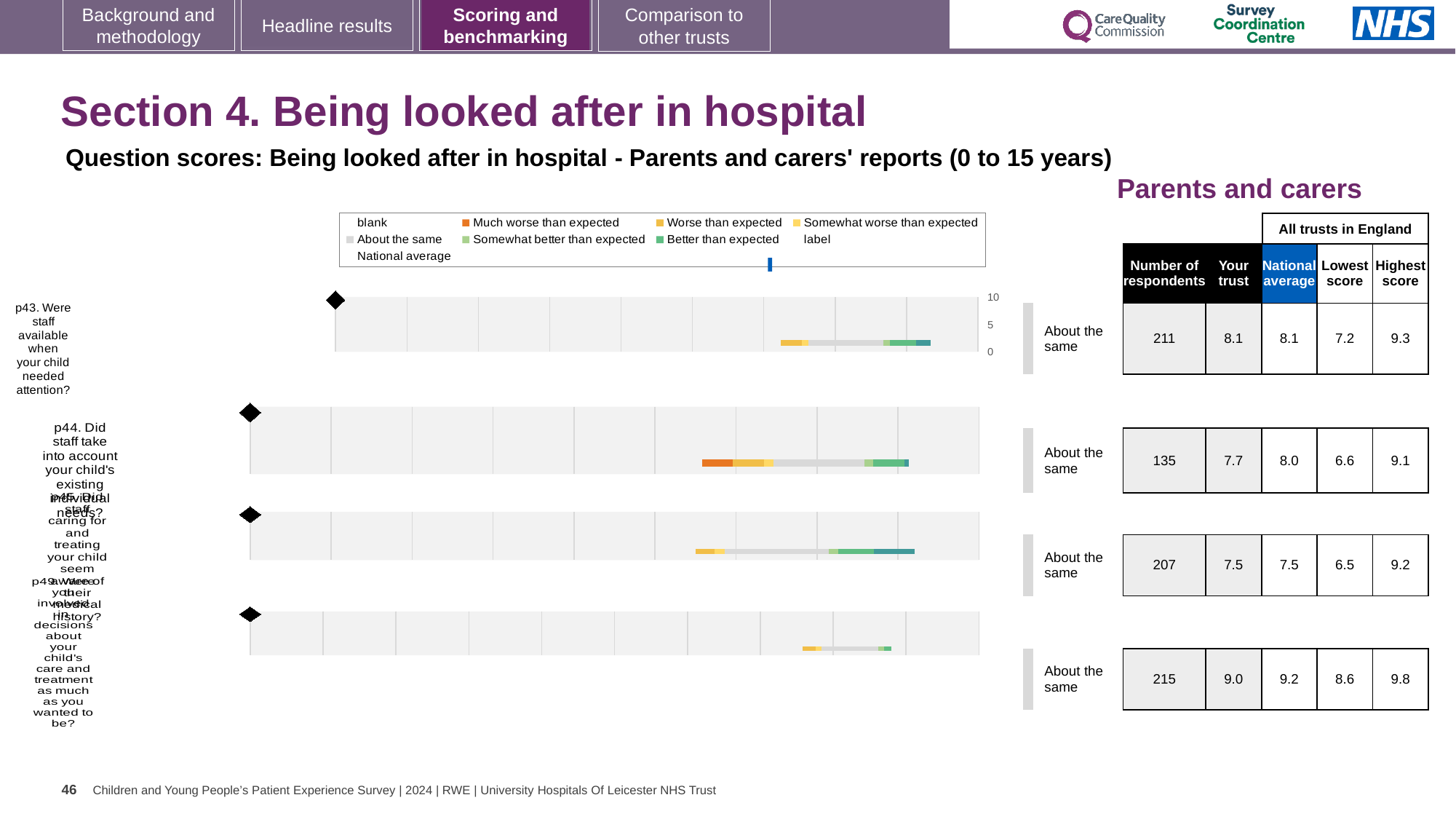
How many question charts are shown on the slide? 4 For the top chart (p43), what is the number of respondents? 211 For the second chart (p44), which is larger: the 'Your trust' score or the national average? National average For the second chart (p44), what is the lowest score among all trusts in England? 6.6 For the top chart (p43, staff available when your child needed attention), what is the 'Your trust' score? 8.1 Which of the four charts has the highest number of respondents? The bottom chart (215) For the top chart (p43), what is the difference between the highest score and the lowest score among all trusts in England? 2.1 For the third chart from the top, what is the highest score among all trusts in England? 9.2 What kind of chart is used for the p43 question (top chart) on the slide? bar chart For the bottom chart, what is the 'Your trust' score? 9.0 For the second chart (p44, staff taking into account your child's existing individual needs), what is the national average score? 8.0 In the legend, what colour represents 'Much worse than expected'? Orange